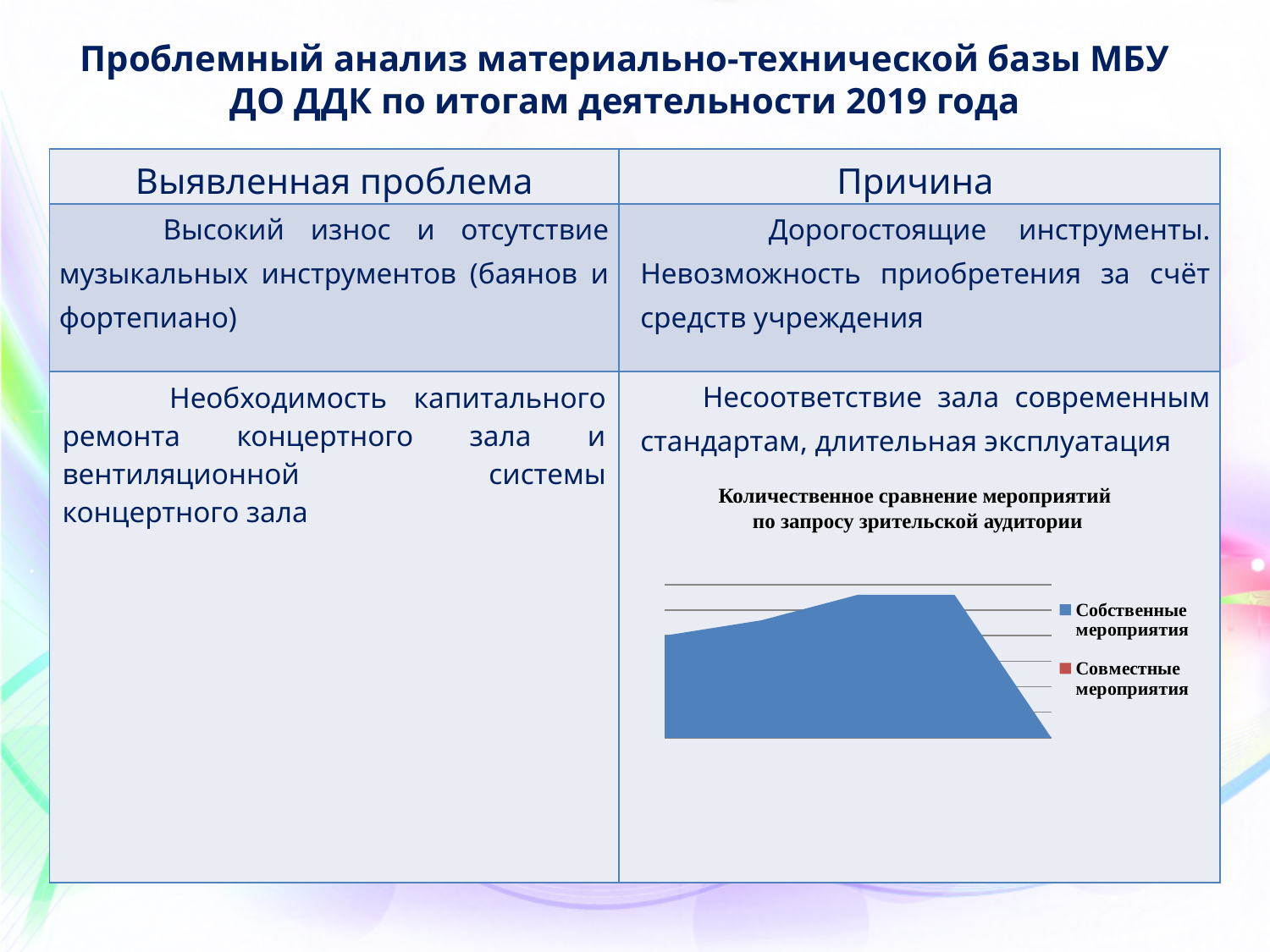
What kind of chart is shown on the slide? Area chart Which series is shown in blue in the chart legend? Собственные мероприятия What is the title of the chart on the slide? Количественное сравнение мероприятий по запросу зрительской аудитории Moving from left to right along the x axis, does the Собственные мероприятия area initially rise or fall? Rise How many series does the chart legend list? 2